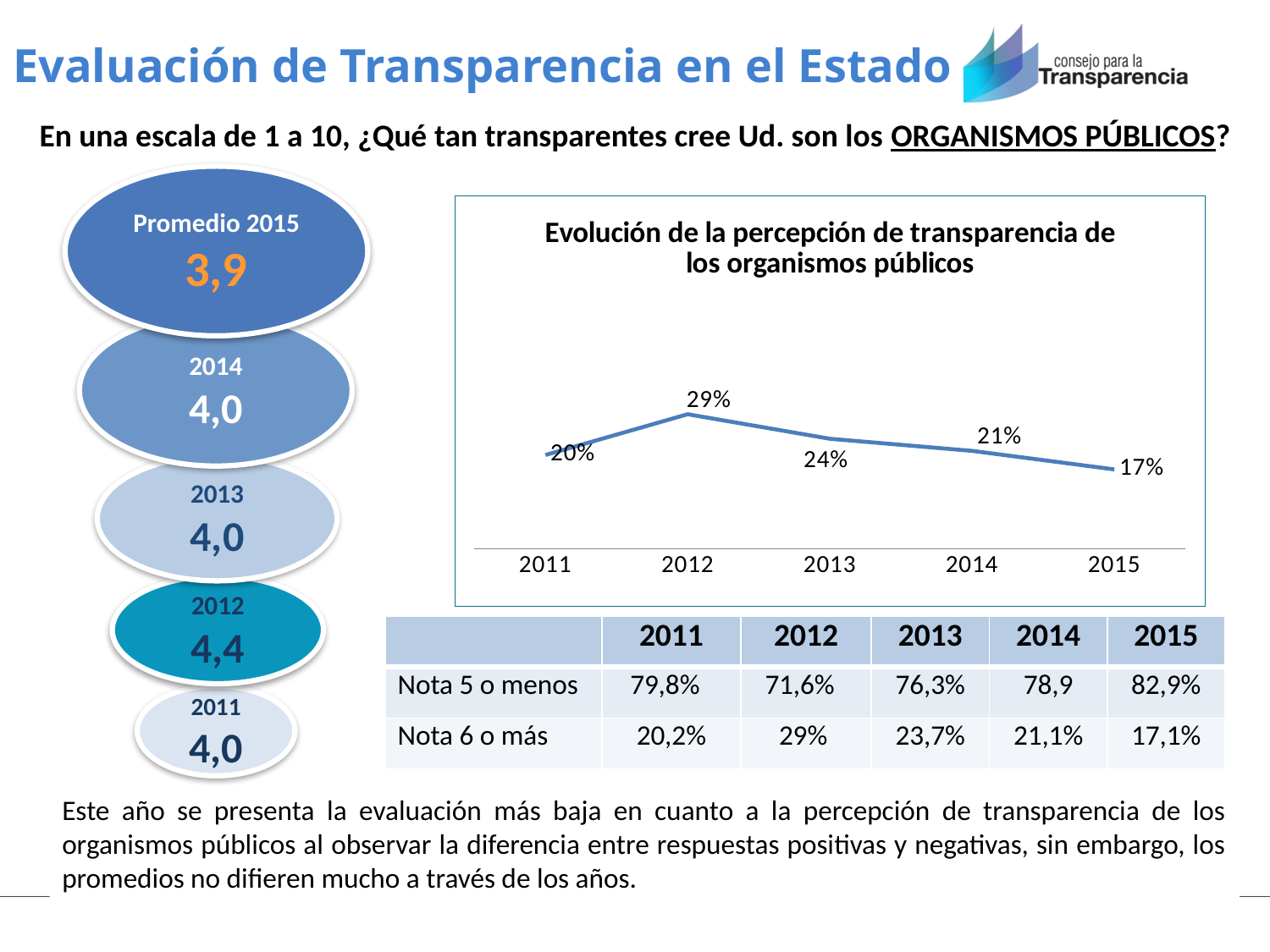
How many years are plotted on the x axis of the line chart? 5 In the line chart, which year has the lowest value? 2015 In the line chart, what is the value for 2015? 17% What type of chart is "Evolución de la percepción de transparencia de los organismos públicos"? line chart In the line chart, what is the difference between the values for 2012 and 2015? 12% In the line chart, which is larger, the value for 2013 or the value for 2014? 2013 In the line chart, what is the value for 2011? 20% In the line chart, do the values rise or fall from 2012 to 2015? fall In the line chart, what is the value for 2012? 29% In the line chart, which year has the highest value? 2012 What is the title of the line chart on the slide? Evolución de la percepción de transparencia de los organismos públicos In the line chart, what is the value for 2013? 24%